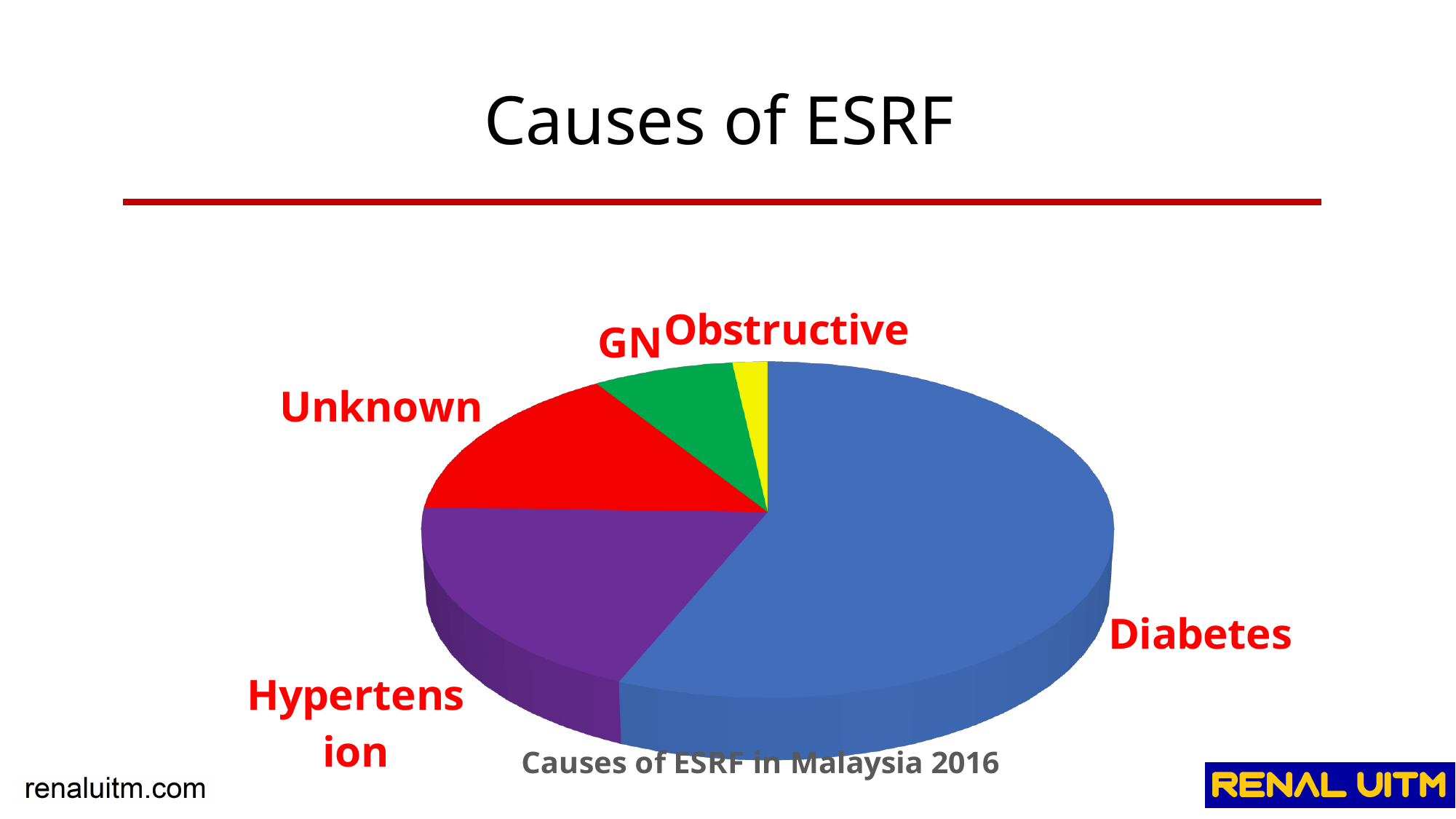
Which slice is larger, Unknown or GN? Unknown Which cause of ESRF has the smallest slice in the pie chart? Obstructive Which cause of ESRF has the largest slice in the pie chart? Diabetes Which slice is larger, GN or Obstructive? GN Which slice is larger, Hypertension or Unknown? Hypertension What colour is the Diabetes slice in the pie chart? Blue What is the title printed below the pie chart? Causes of ESRF in Malaysia 2016 How many categories (slices) does the pie chart show? 5 What kind of chart is shown on the slide? Pie chart